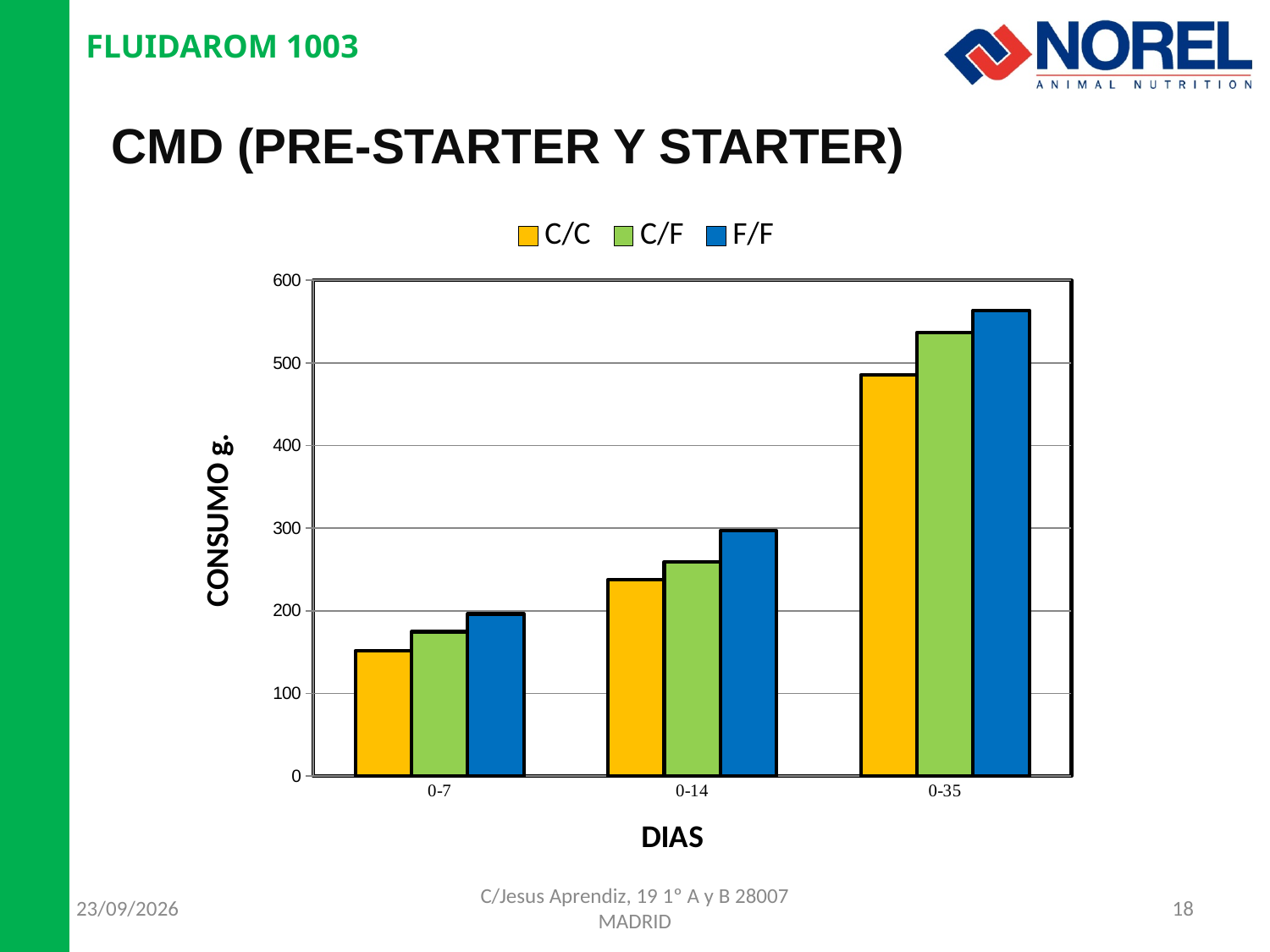
Is the value for C/C in the 0-7 category greater or less than 200? less How many categories are shown on the DIAS axis? 3 What kind of chart is shown on the slide? bar chart Which is larger in the 0-14 category, C/F or F/F? F/F Which series has the highest bar in the 0-35 category? F/F Is the value for F/F in the 0-35 category greater or less than 500? greater Do the values for the F/F series rise or fall from 0-7 to 0-35? rise What is the label of the vertical axis? CONSUMO g. How many series does the legend list? 3 Which series has the lowest bar in the 0-7 category? C/C Is the value for C/C in the 0-14 category greater or less than 200? greater For the C/C series, which category has the highest value? 0-35